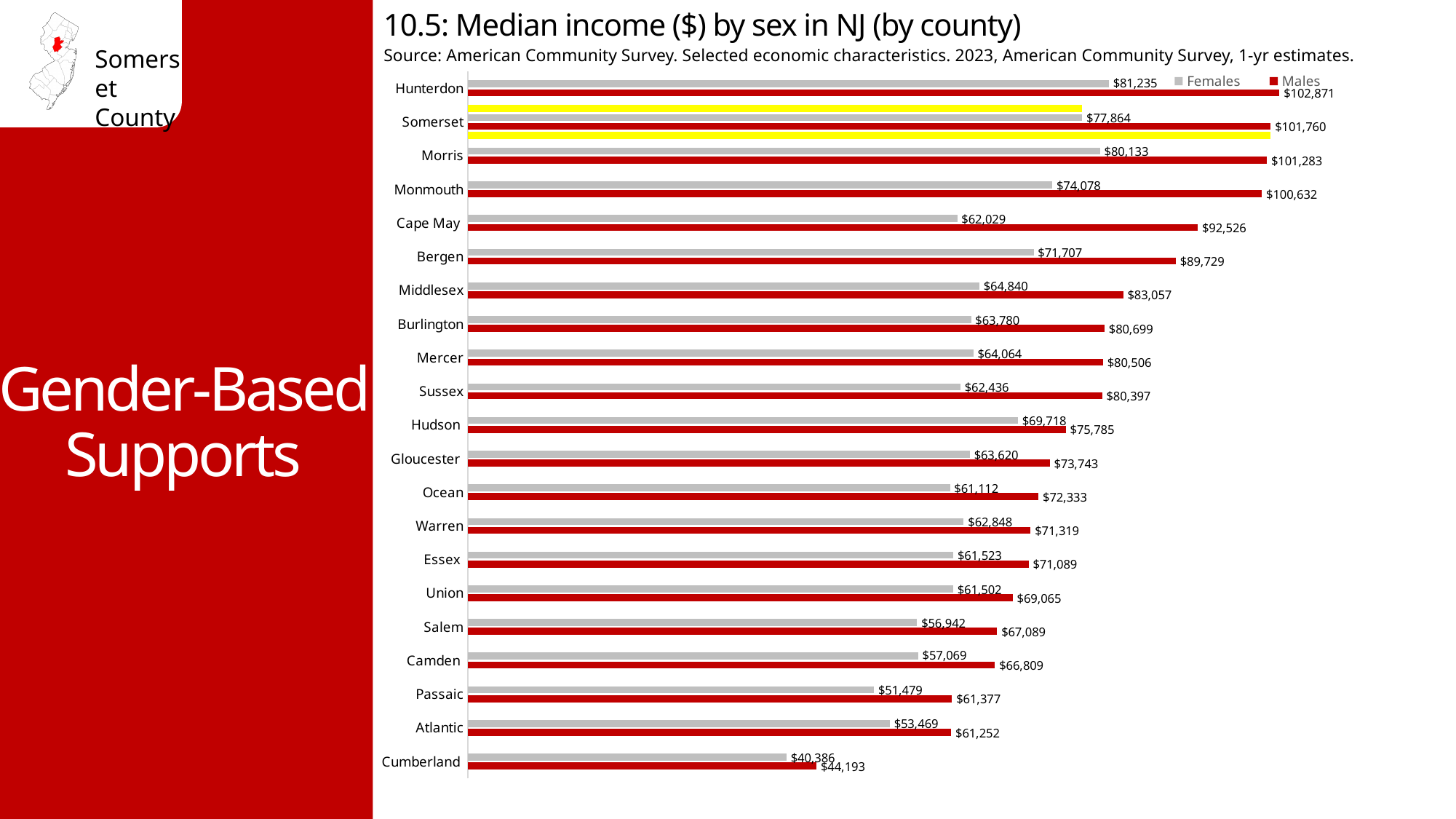
Which is larger, the female median income in Bergen or in Hudson? Bergen Which county has the lowest median income for females? Cumberland Which county has the highest median income for males? Hunterdon What is the median income for males in Cumberland County? $44,193 How many counties are shown in the chart? 21 What is the median income for males in Monmouth County? $100,632 How many series does the legend list? 2 What kind of chart is shown on the slide? Bar chart What is the difference between male and female median income in Cumberland County? $3,807 Which colour represents Males in the chart? Red What is the median income for females in Somerset County? $77,864 What is the difference between male and female median income in Somerset County? $23,896